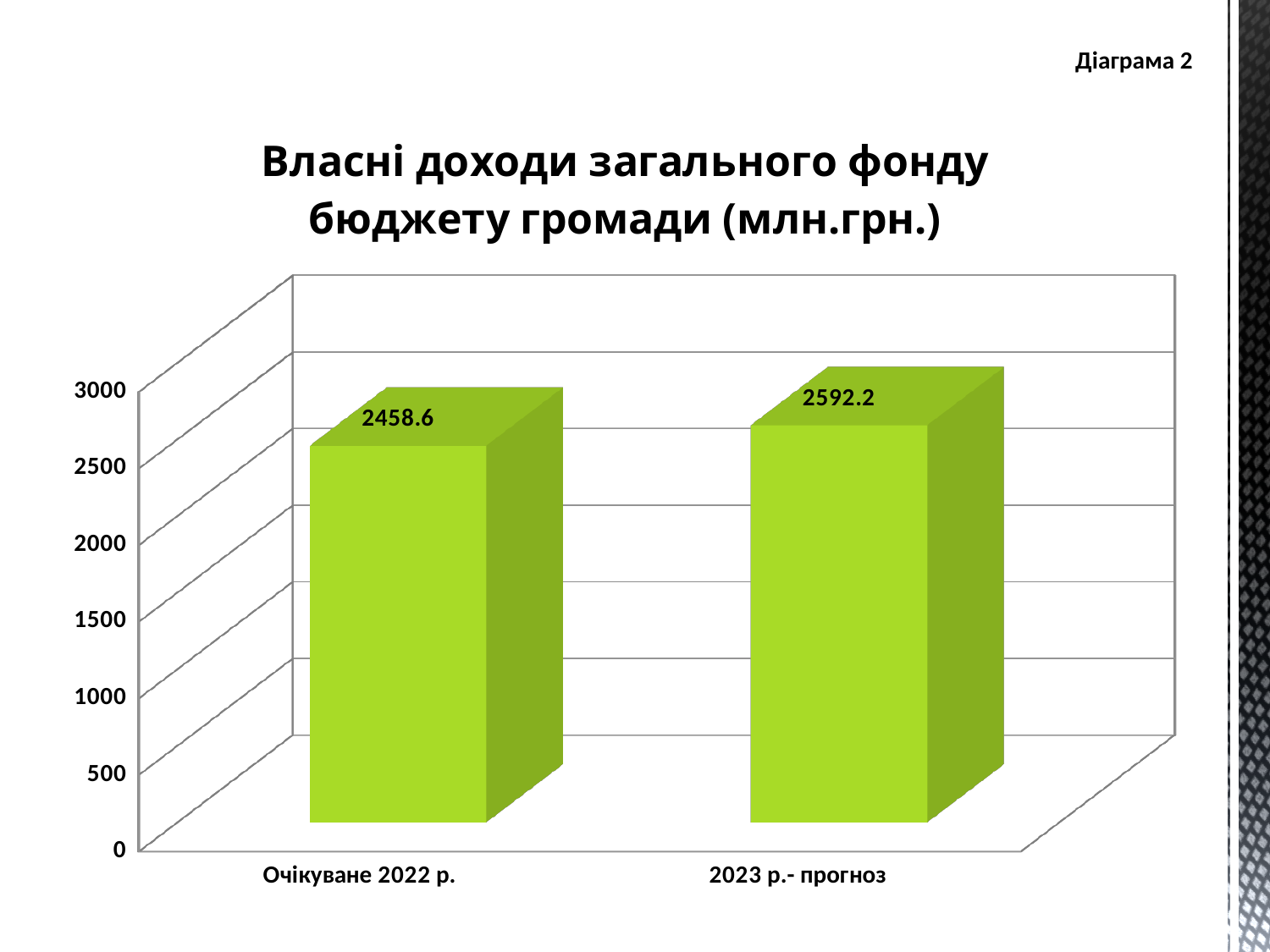
Which category has the lowest value? Очікуване 2022 р. Which is larger, the value for Очікуване 2022 р. or the value for 2023 р.- прогноз? 2023 р.- прогноз What is the value for Очікуване 2022 р.? 2458.6 How many categories are shown on the chart? 2 Is the value for 2023 р.- прогноз greater or less than 3000? less Do the values rise or fall from Очікуване 2022 р. to 2023 р.- прогноз? rise Which category has the highest value? 2023 р.- прогноз What kind of chart is shown on the slide? bar chart What is the title of the chart? Власні доходи загального фонду бюджету громади (млн.грн.) What is the difference between the value for 2023 р.- прогноз and the value for Очікуване 2022 р.? 133.6 Is the value for Очікуване 2022 р. greater or less than 2000? greater What is the value for 2023 р.- прогноз? 2592.2